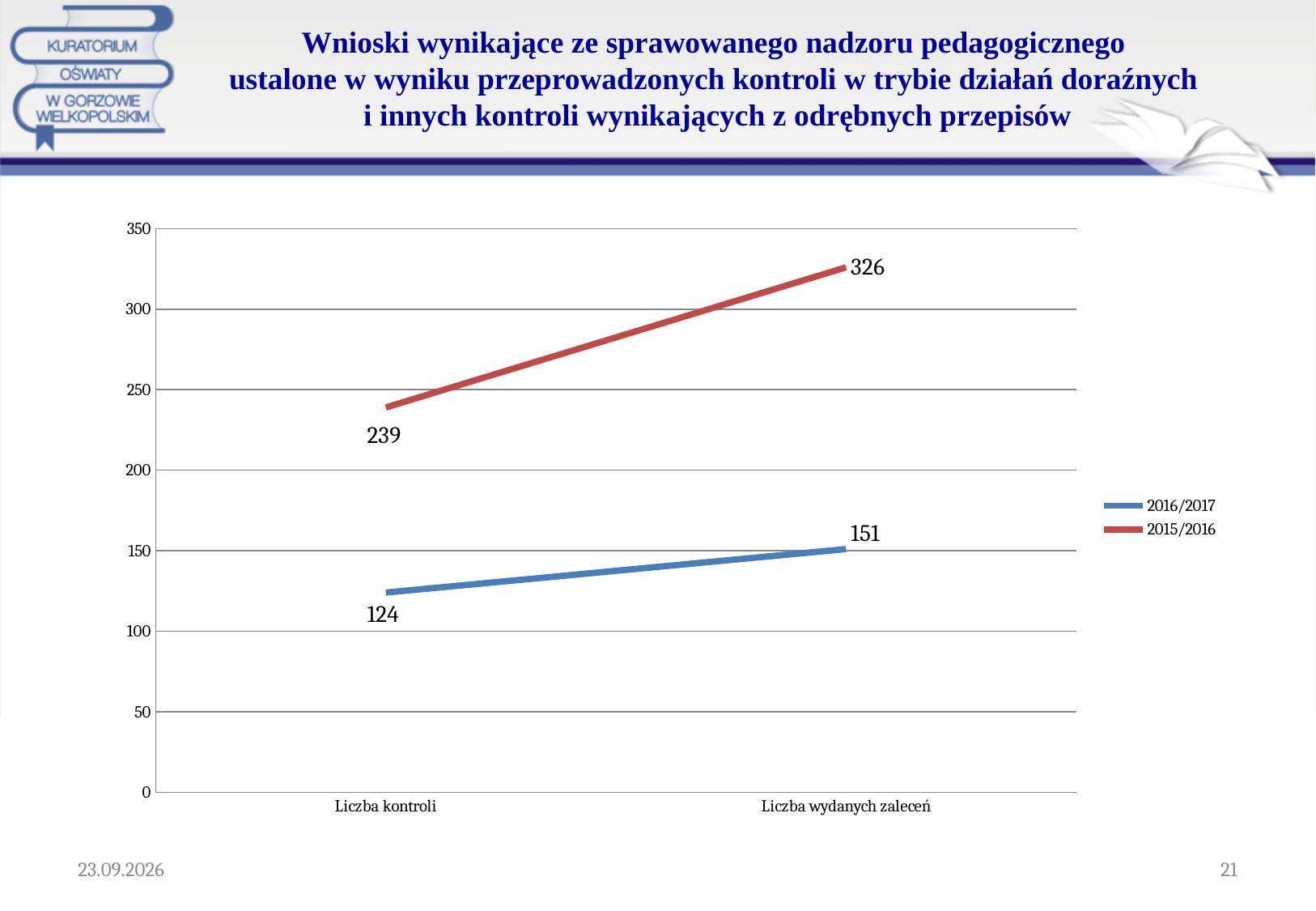
What kind of chart is shown on the slide? line chart What is the value for Liczba wydanych zaleceń in the 2015/2016 series? 326 How many categories are shown on the x axis? 2 What is the value for Liczba wydanych zaleceń in the 2016/2017 series? 151 How many series does the legend list? 2 What is the value for Liczba kontroli in the 2015/2016 series? 239 Which series has the higher value for Liczba wydanych zaleceń? 2015/2016 Which colour is used for the 2015/2016 series? red What is the difference between the 2015/2016 and 2016/2017 values for Liczba wydanych zaleceń? 175 What is the difference between the 2015/2016 and 2016/2017 values for Liczba kontroli? 115 Does the 2016/2017 series rise or fall from Liczba kontroli to Liczba wydanych zaleceń? rise What is the value for Liczba kontroli in the 2016/2017 series? 124